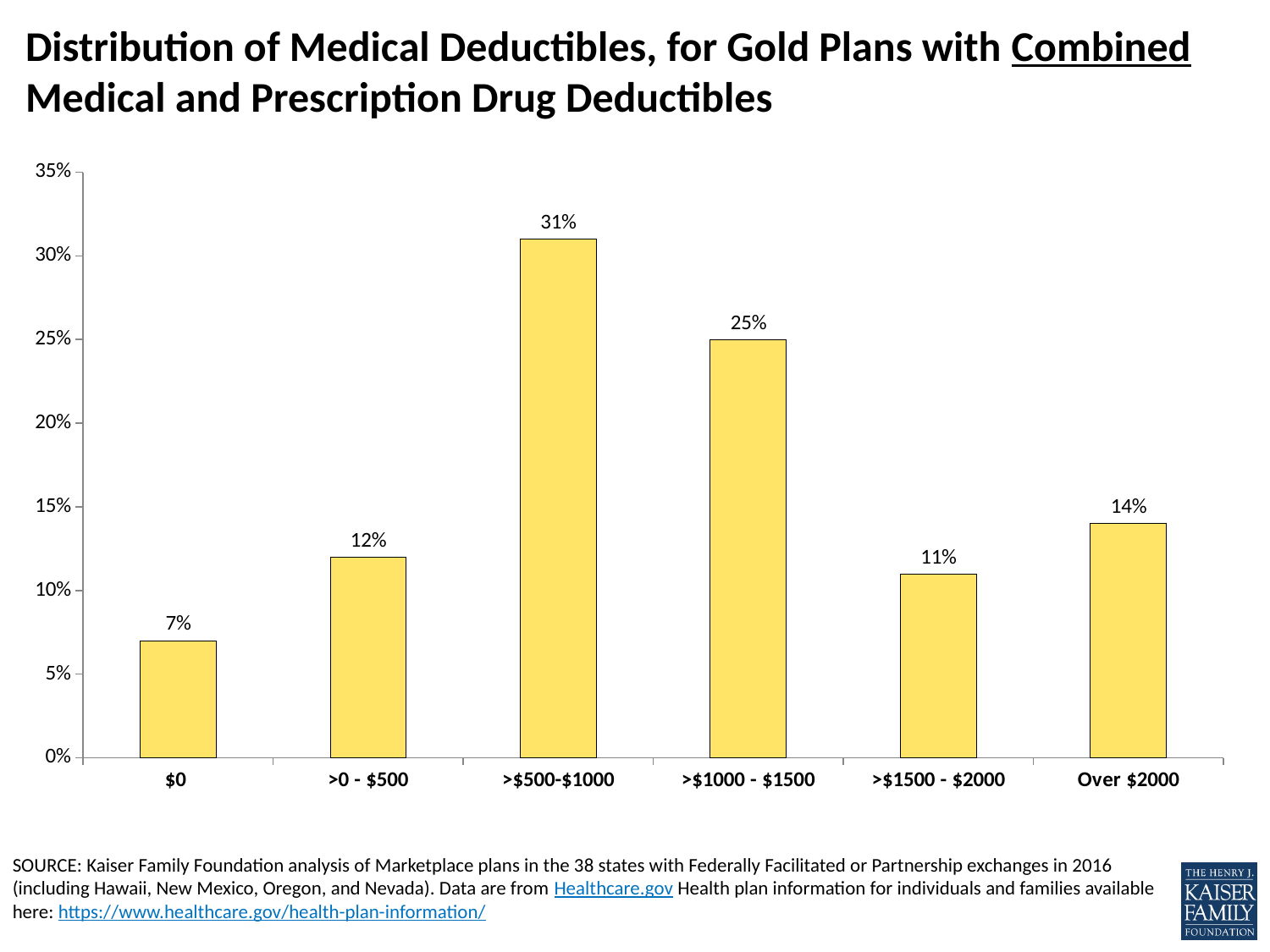
Which deductible category has the lowest share of plans? $0 Is the value for >$1000 - $1500 greater or less than 20%? greater Which deductible category has the highest share of plans? >$500-$1000 What is the combined share of the $0 and >0 - $500 categories? 19% What is the maximum value shown on the vertical axis? 35% What is the difference between the >$500-$1000 and >$1000 - $1500 categories? 6 percentage points What kind of chart is shown on the slide? Bar chart What is the value shown for the >$500-$1000 deductible category? 31% What percentage of gold plans with combined deductibles have a medical deductible of $0? 7% Which is larger, the share for >0 - $500 or the share for >$1500 - $2000? >0 - $500 What percentage of plans fall in the Over $2000 deductible category? 14% How many deductible categories are shown on the x axis? 6